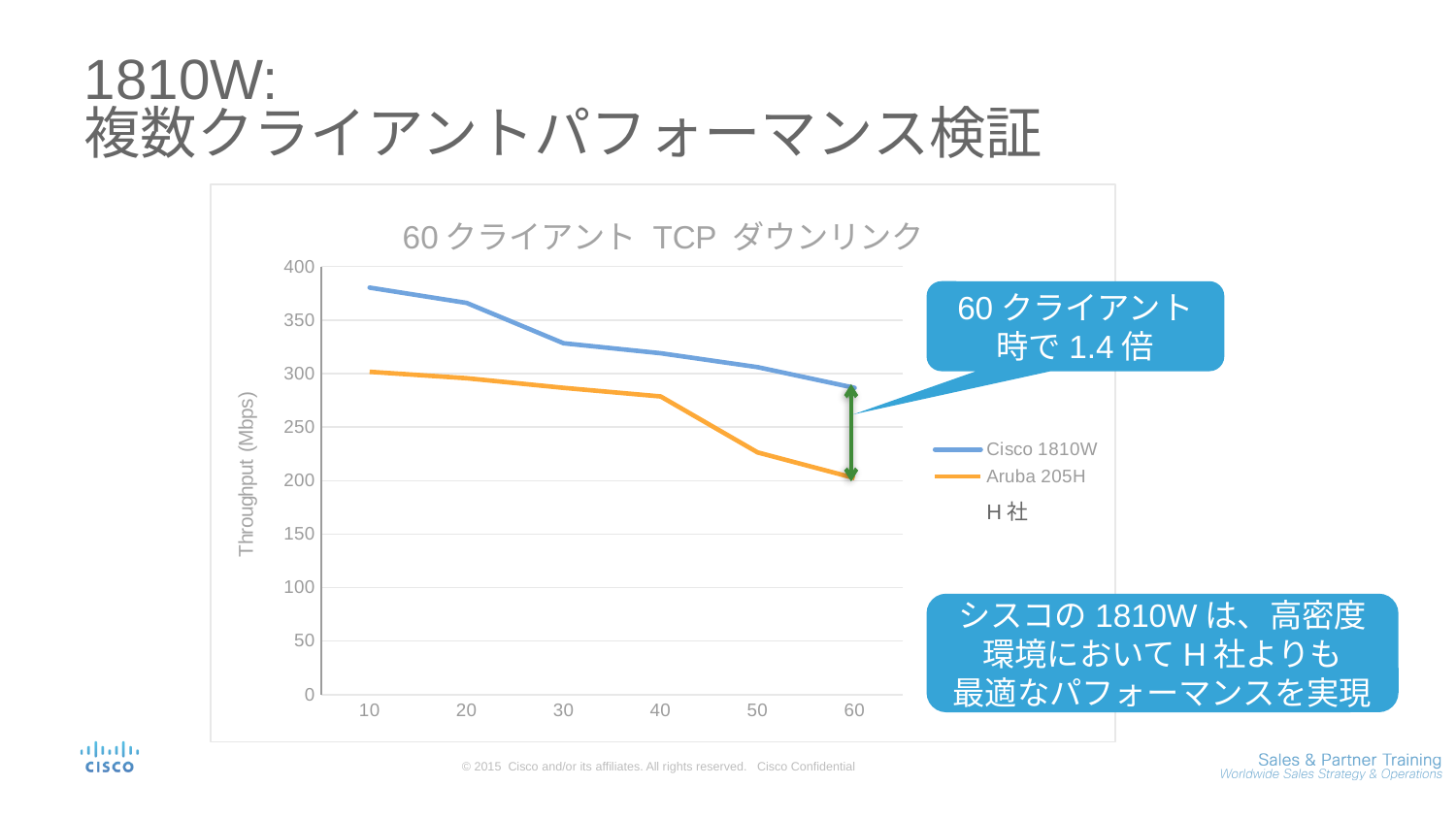
Does the throughput of the Cisco 1810W rise or fall as the number of clients increases from 10 to 60? fall How many series does the legend list? 2 At 60 clients, which series has the higher throughput, Cisco 1810W or Aruba 205H? Cisco 1810W Is the Aruba 205H throughput at 40 clients greater or less than 250 Mbps? greater At which client count does the Cisco 1810W reach its highest throughput? 10 Does the throughput of the Aruba 205H rise or fall as the number of clients increases from 10 to 60? fall At 10 clients, which series has the higher throughput, Cisco 1810W or Aruba 205H? Cisco 1810W What kind of chart is shown on the slide? line chart How many client-count points are plotted along the x axis? 6 Is the Cisco 1810W throughput at 10 clients greater or less than 350 Mbps? greater What is the title of the chart? 60 クライアント TCP ダウンリンク Is the Aruba 205H throughput at 60 clients greater or less than 250 Mbps? less